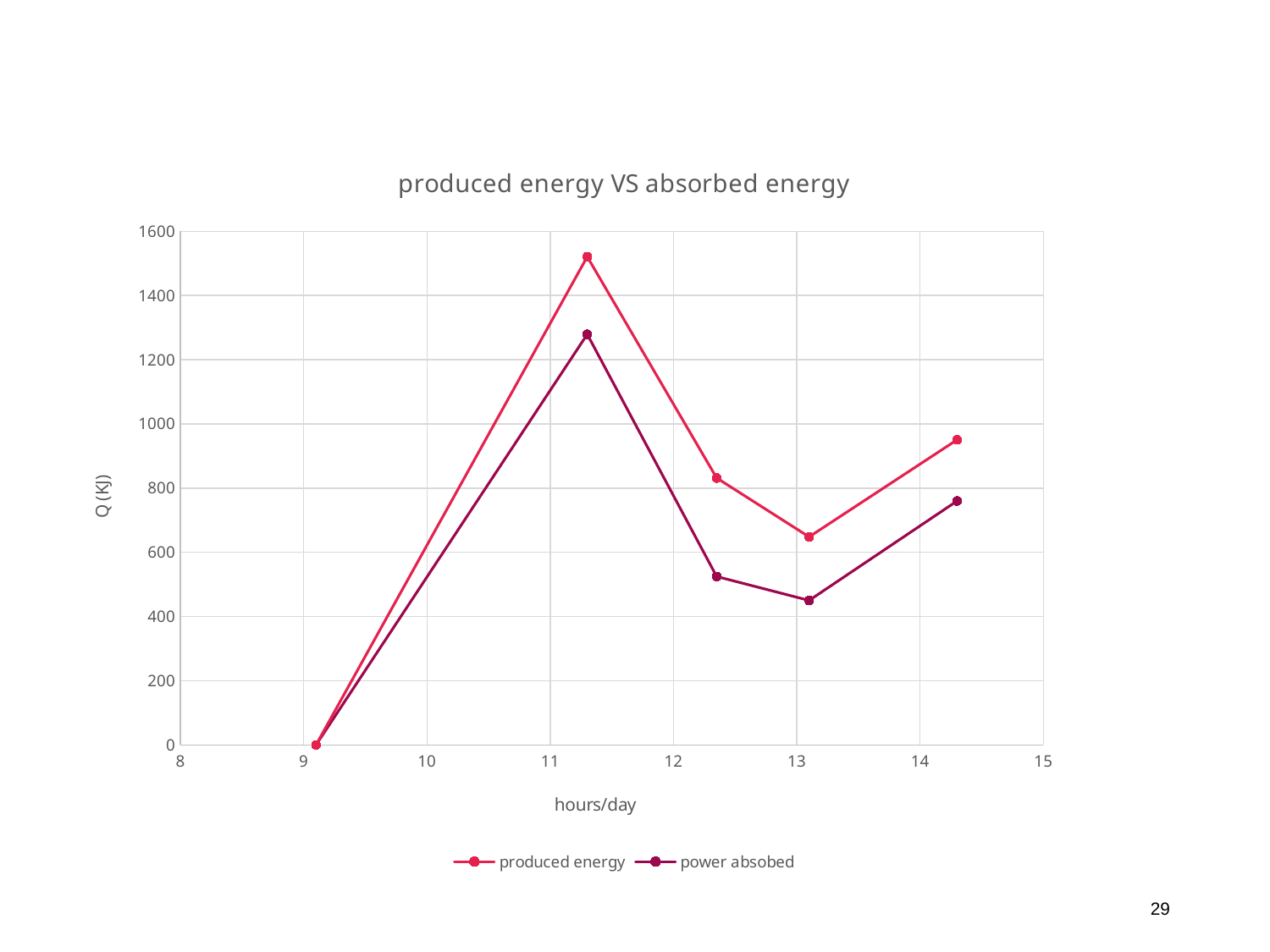
Is the peak value of the power absobed series greater or less than 1400? less How many series does the legend list? 2 What is the title of the chart? produced energy VS absorbed energy Is the last plotted value of the power absobed series greater or less than 800? less How many data points are plotted for the produced energy series? 5 Between the peak and the next plotted point, do the values of the produced energy series rise or fall? fall Which series reaches the higher peak, produced energy or power absobed? produced energy Is the last plotted value of the produced energy series greater or less than 800? greater What kind of chart is shown on the slide? line chart What is the value of the produced energy series at its first plotted point? 0 What is the label on the y axis? Q (KJ)